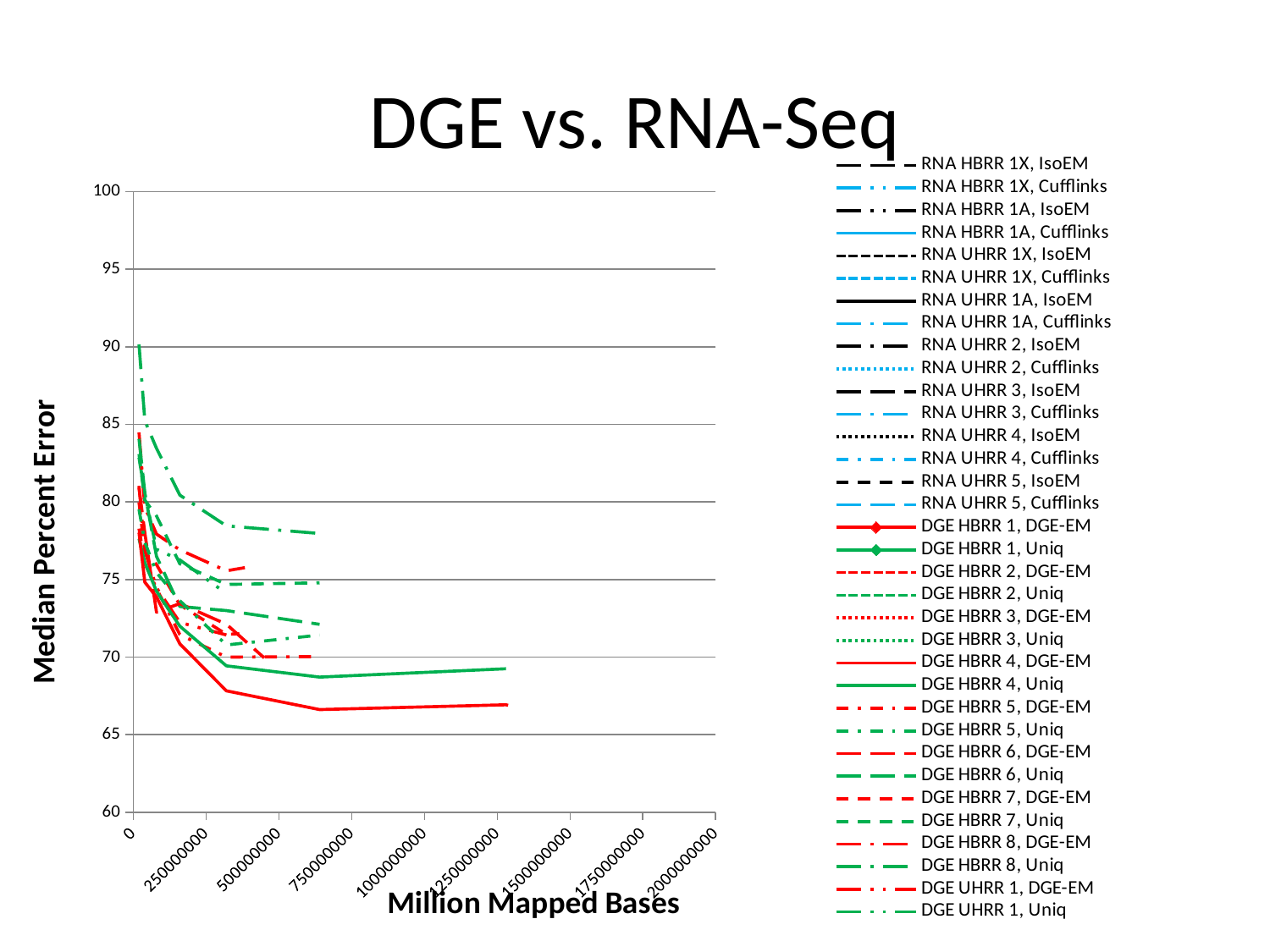
What is the title of the chart? DGE vs. RNA-Seq What kind of chart is shown on the slide? line chart As Million Mapped Bases increases, do the plotted Median Percent Error values rise or fall? fall Is the highest plotted value on the chart greater or less than 85? greater What is the largest tick value shown on the x axis? 2000000000 Is the lowest plotted value on the chart greater or less than 70? less Is the rightmost point of the solid red line greater or less than 70? less How many series does the legend list? 34 What is the label of the y axis? Median Percent Error